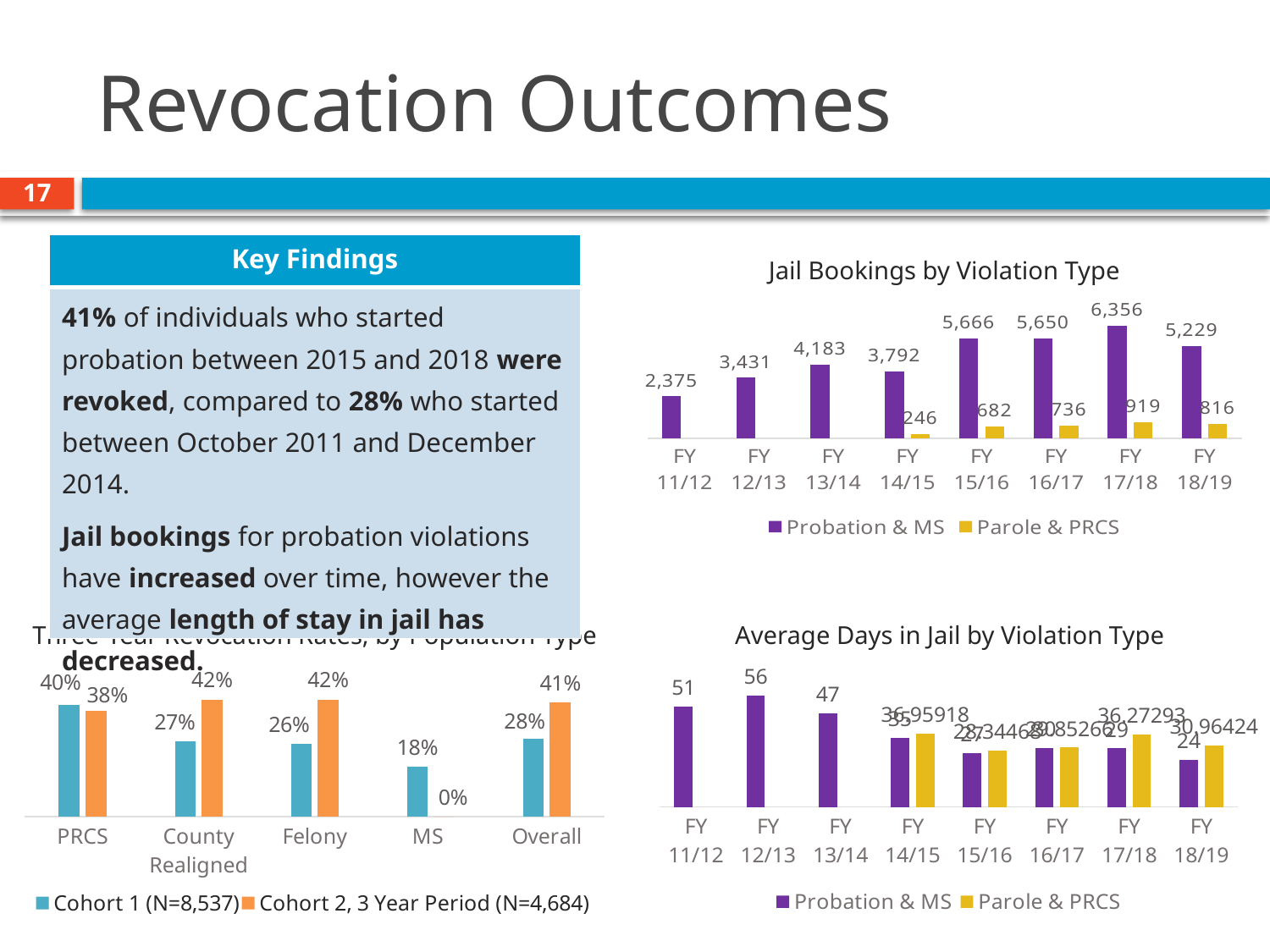
In the Jail Bookings by Violation Type chart, what is the difference between the Probation & MS values for FY 17/18 and FY 18/19? 1,127 In the Jail Bookings by Violation Type chart, what is the Probation & MS value for FY 17/18? 6,356 In the Average Days in Jail by Violation Type chart, which fiscal year has the highest Probation & MS value? FY 12/13 In the Jail Bookings by Violation Type chart, which fiscal year has the highest Probation & MS bookings? FY 17/18 In the Jail Bookings by Violation Type chart, which fiscal year has the lowest Parole & PRCS bookings? FY 14/15 In the Jail Bookings by Violation Type chart, what is the Parole & PRCS value for FY 14/15? 246 In the Jail Bookings by Violation Type chart, how many series does the legend list? 2 In the bottom-left chart of revocation rates by population type, what is the Cohort 1 (N=8,537) value for MS? 18% In the bottom-left chart of revocation rates by population type, how many population categories are shown on the x axis? 5 What type of chart is the Average Days in Jail by Violation Type chart? Bar chart In the bottom-left chart of revocation rates by population type, which is larger for County Realigned: Cohort 1 or Cohort 2? Cohort 2, 3 Year Period (N=4,684) In the bottom-left chart of revocation rates by population type, what is the difference between the Cohort 2 and Cohort 1 values for Overall? 13%